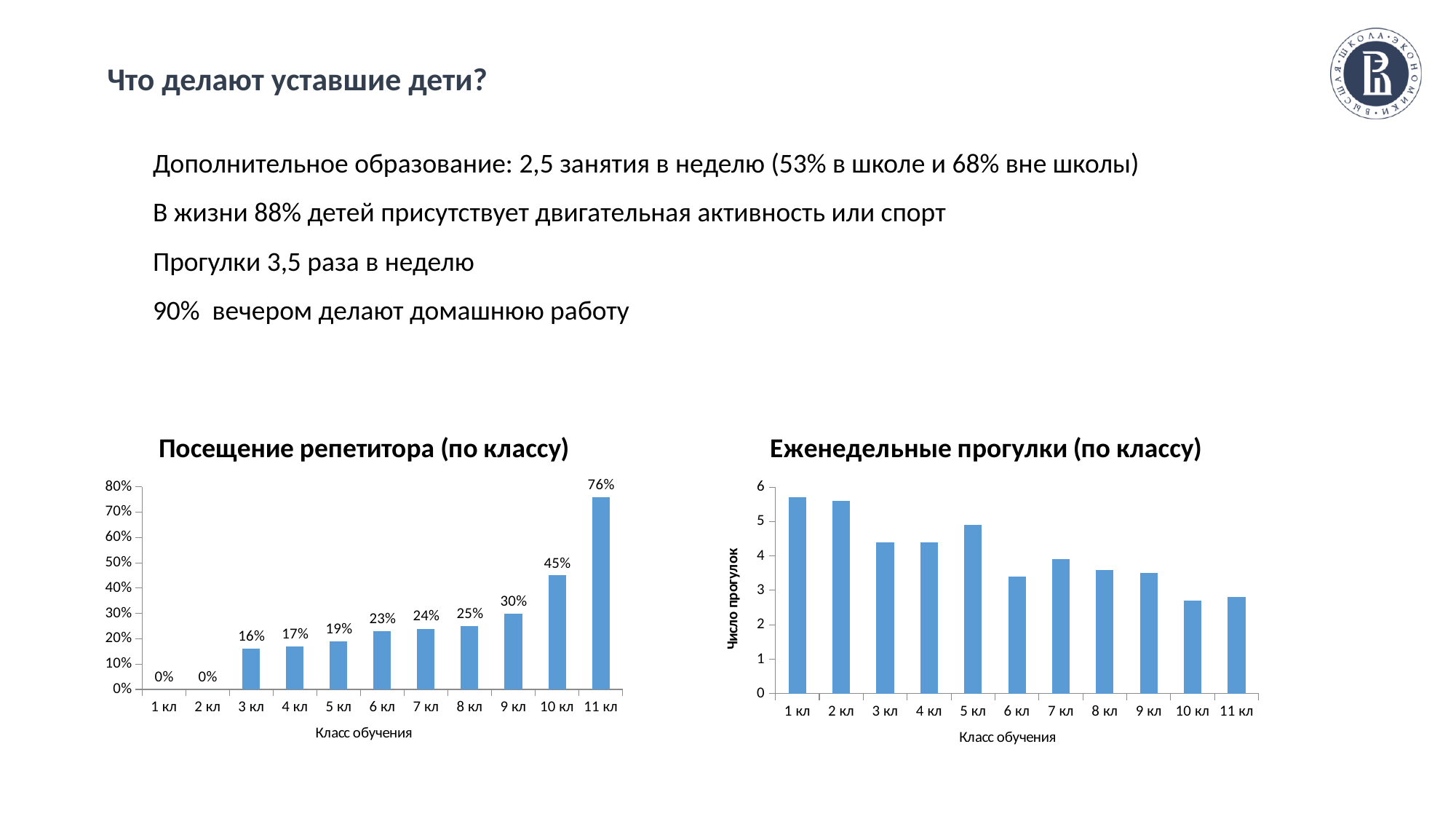
In the chart 'Посещение репетитора (по классу)', which class has the highest value? 11 кл In the chart 'Еженедельные прогулки (по классу)', is the value for 1 кл greater or less than 5? greater In the chart 'Посещение репетитора (по классу)', how many classes are shown on the x axis? 11 In the chart 'Посещение репетитора (по классу)', what is the value for 1 кл? 0% In the chart 'Посещение репетитора (по классу)', what is the value for 5 кл? 19% In the chart 'Посещение репетитора (по классу)', what is the value for 11 кл? 76% In the chart 'Еженедельные прогулки (по классу)', is the value for 10 кл greater or less than 3? less In the chart 'Посещение репетитора (по классу)', what is the difference between the values for 10 кл and 9 кл? 15% In the chart 'Посещение репетитора (по классу)', do the values generally rise or fall from 1 кл to 11 кл? rise In the chart 'Еженедельные прогулки (по классу)', do the values generally rise or fall from 1 кл to 11 кл? fall In the chart 'Еженедельные прогулки (по классу)', which is larger, the value for 5 кл or the value for 6 кл? 5 кл What type of chart is 'Еженедельные прогулки (по классу)'? bar chart